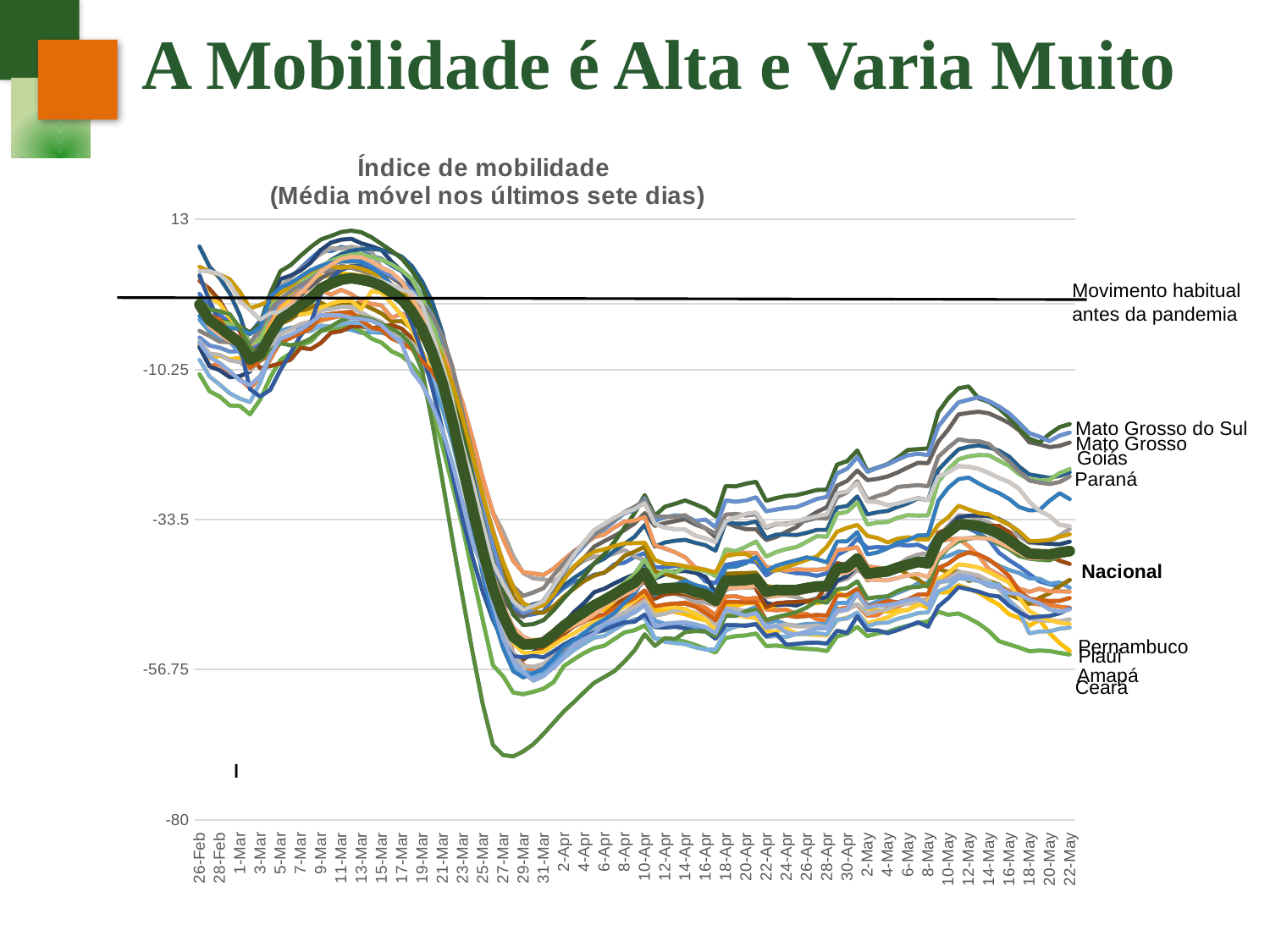
Which series has the highest value at the end of the period (22-May)? Mato Grosso do Sul Is the value of the Nacional line on 11-Mar greater or less than -10.25? greater At 22-May, which is higher: Nacional or Paraná? Paraná Is the value of the Nacional line on 22-May greater or less than -56.75? greater At 22-May, which is higher: Mato Grosso do Sul or Pernambuco? Mato Grosso do Sul What is the title of the chart? Índice de mobilidade (Média móvel nos últimos sete dias) Is the value of the Nacional line on 22-May greater or less than -33.5? less Do the lines rise or fall between 13-Mar and 27-Mar? fall What kind of chart is shown on the slide? line chart What does the horizontal black line across the chart represent? Movimento habitual antes da pandemia